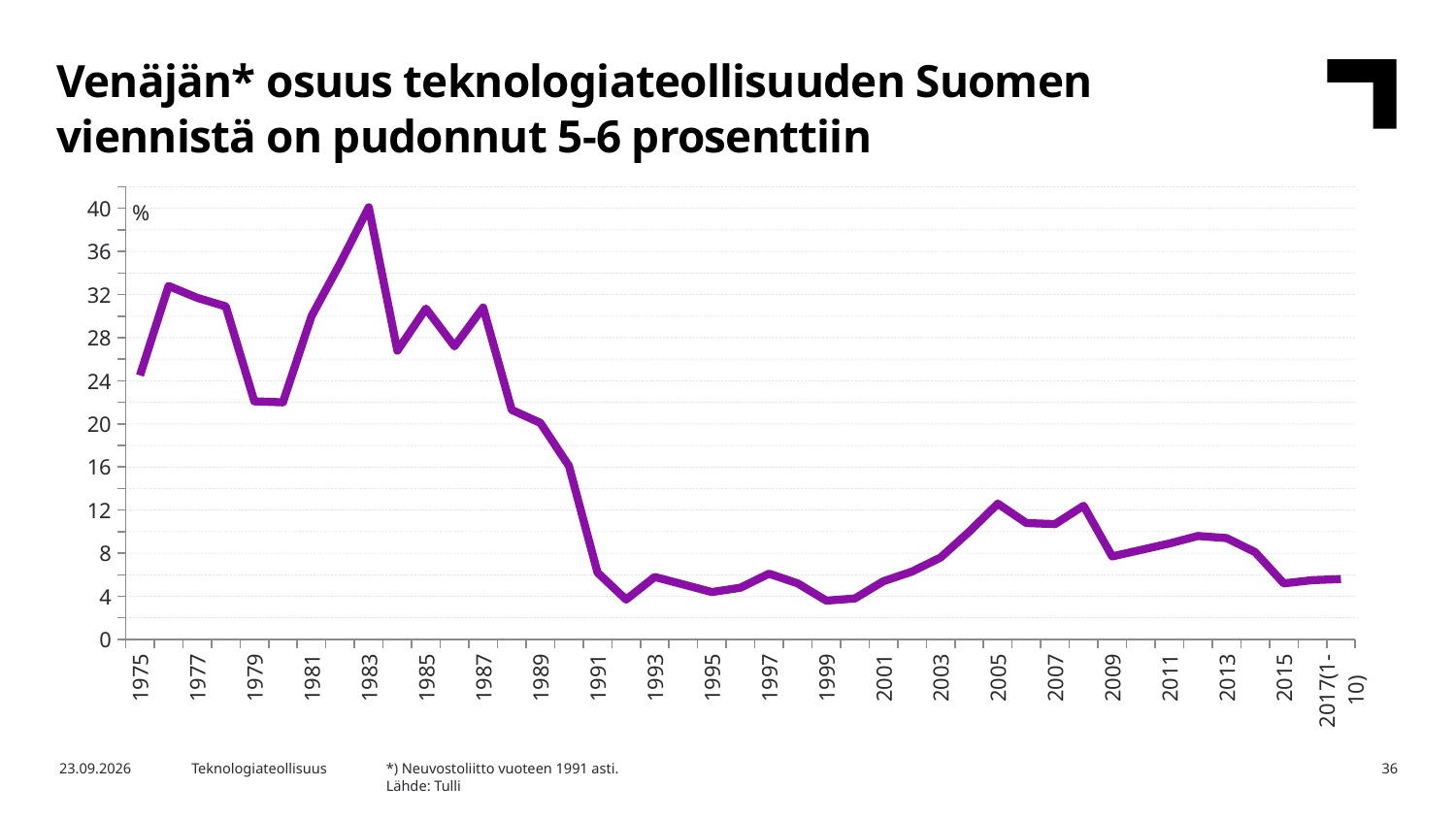
Is the value for 2009 greater or less than 12? less Is the value for 1991 greater or less than 8? less Is the value for 1983 greater or less than 36? greater Which year has the larger value, 1975 or 2015? 1975 What kind of chart is shown on the slide? line chart Which year has the larger value, 2005 or 2009? 2005 In which year does the line reach its highest value? 1983 What unit is shown at the top of the y axis? % Overall, does the line rise or fall from 1975 to 2017(1-10)? fall